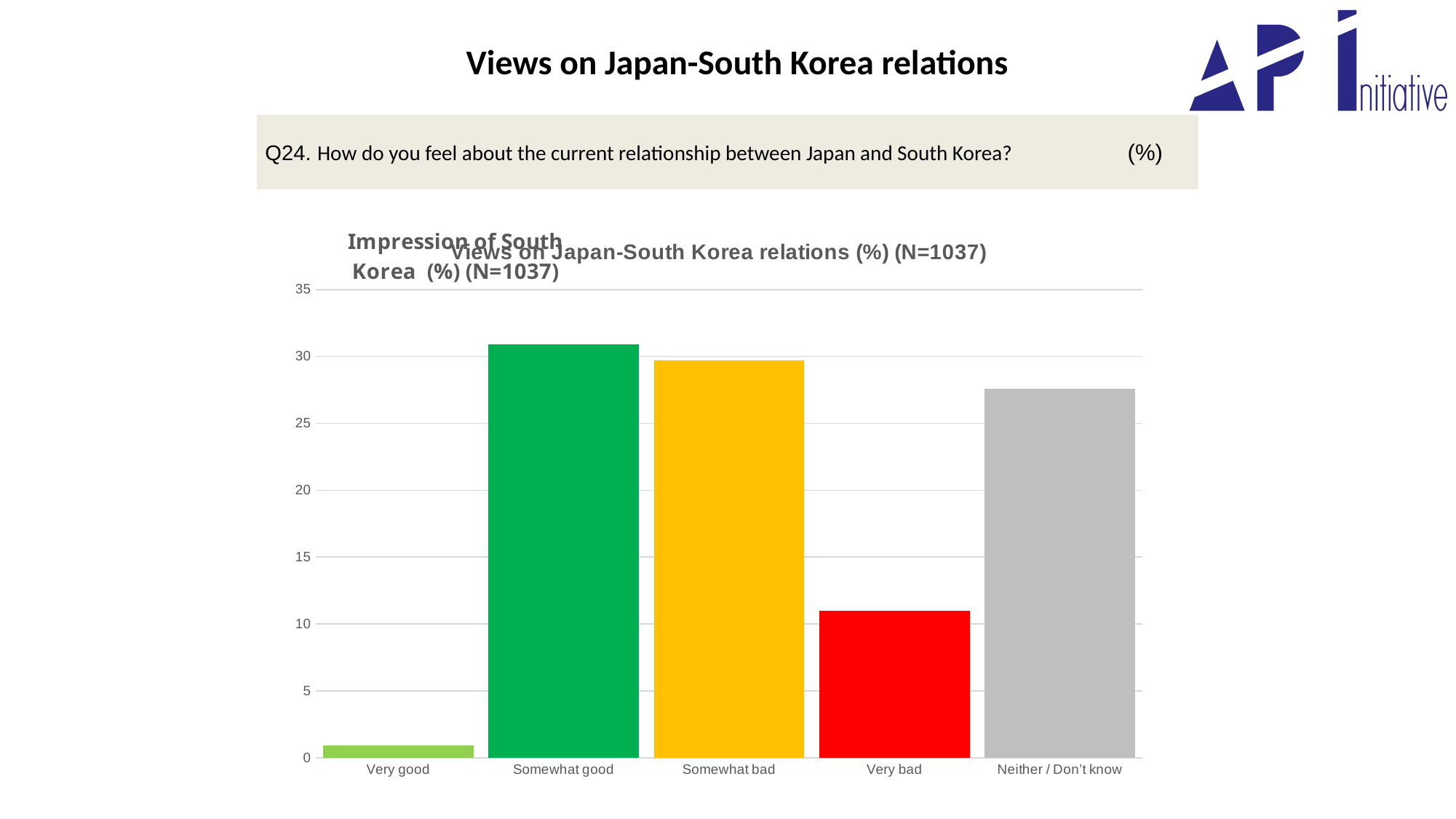
Which is larger, the value for Somewhat good or the value for Neither / Don't know? Somewhat good Is the value for Very bad greater or less than 10? greater Is the value for Somewhat good greater or less than 30? greater What colour is the bar for Very bad? red What sample size (N) is given in the chart title? 1037 Which category has the lowest value in the chart? Very good Is the value for Very good greater or less than 5? less What kind of chart is shown on the slide? bar chart Which is larger, the value for Very bad or the value for Somewhat bad? Somewhat bad How many categories are shown on the x axis of the chart? 5